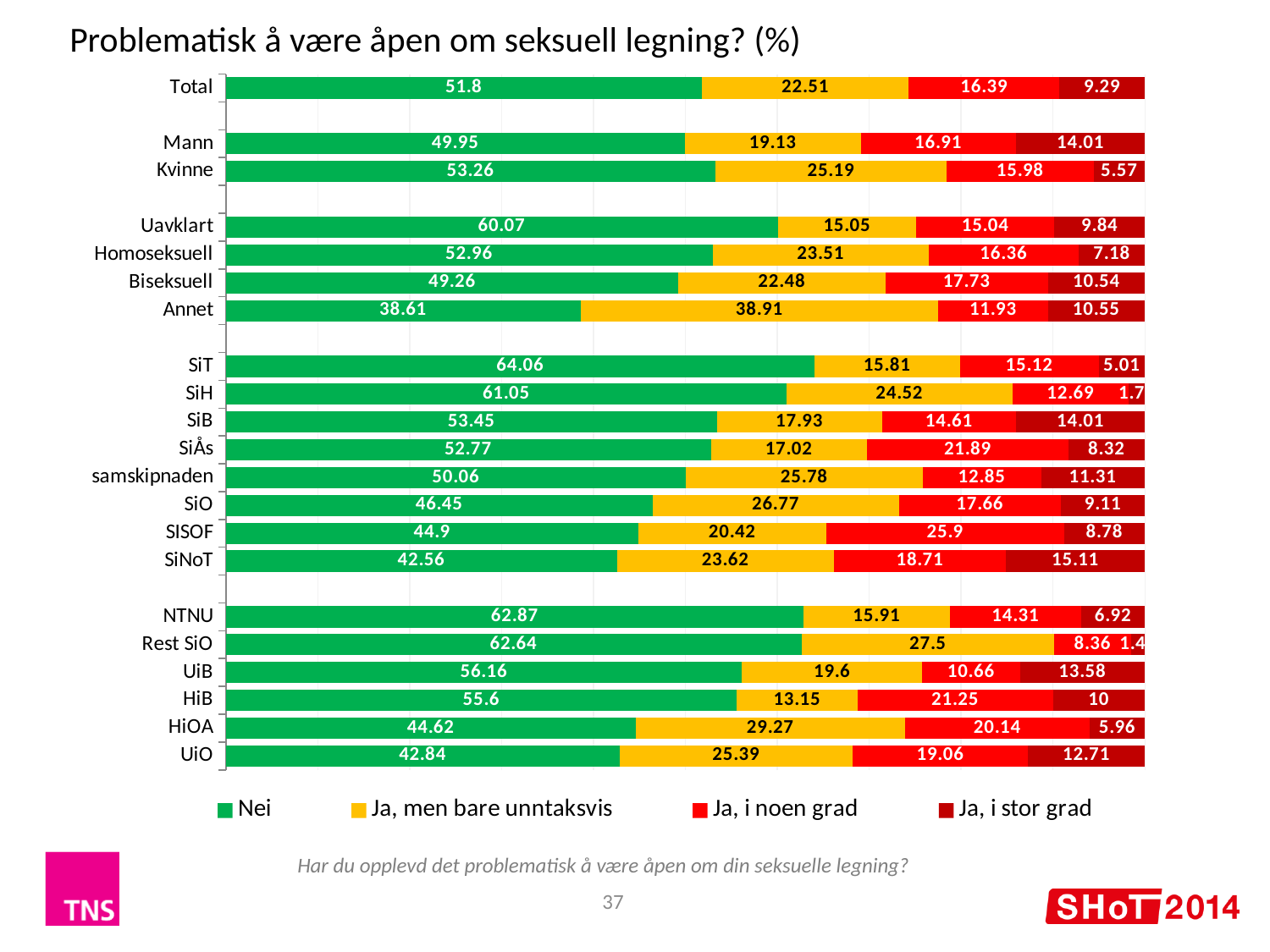
What is the total of the stacked bar for SiT? 100 How many categories are shown on the chart? 21 How many series does the legend list? 4 What is the value of "Ja, men bare unntaksvis" for Annet? 38.91 Which category has the lowest "Nei" value? Annet Which category has the highest "Nei" value? SiT Which has a larger "Ja, i noen grad" value, SISOF or SiNoT? SISOF What is the first entry in the legend? Nei What kind of chart is shown on the slide? Stacked bar chart What is the value of "Ja, i stor grad" for Mann? 14.01 What is the difference between the "Nei" values for Kvinne and Mann? 3.31 What is the value of "Nei" for SiT? 64.06